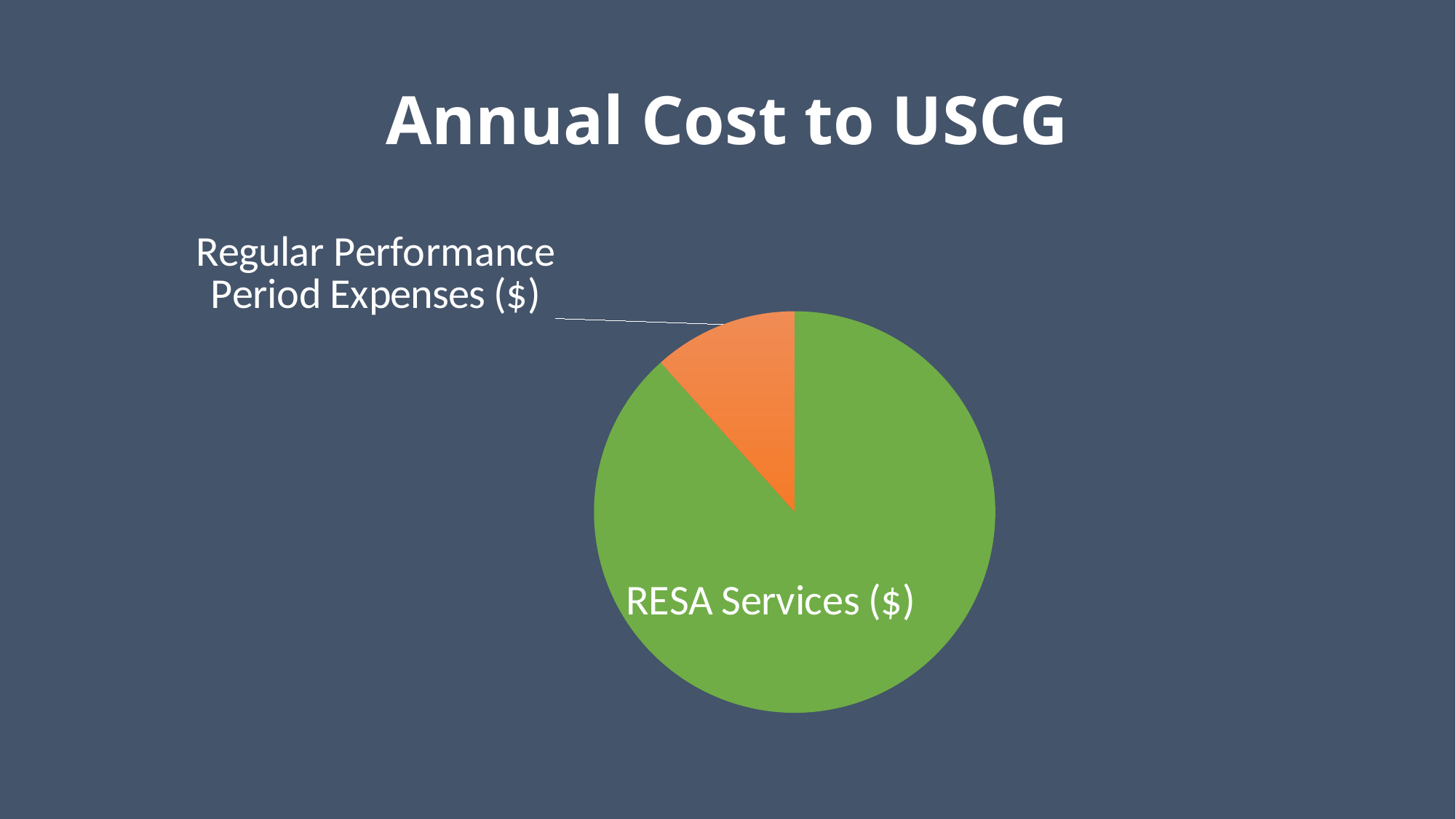
What colour is the RESA Services ($) slice? green Which slice is shown in orange? Regular Performance Period Expenses ($) How many slices does the pie chart have? 2 What is the title of the chart? Annual Cost to USCG Which is larger, RESA Services ($) or Regular Performance Period Expenses ($)? RESA Services ($) Which slice is the largest in the pie chart? RESA Services ($) What kind of chart is shown on the slide? pie chart Which slice is the smallest in the pie chart? Regular Performance Period Expenses ($)